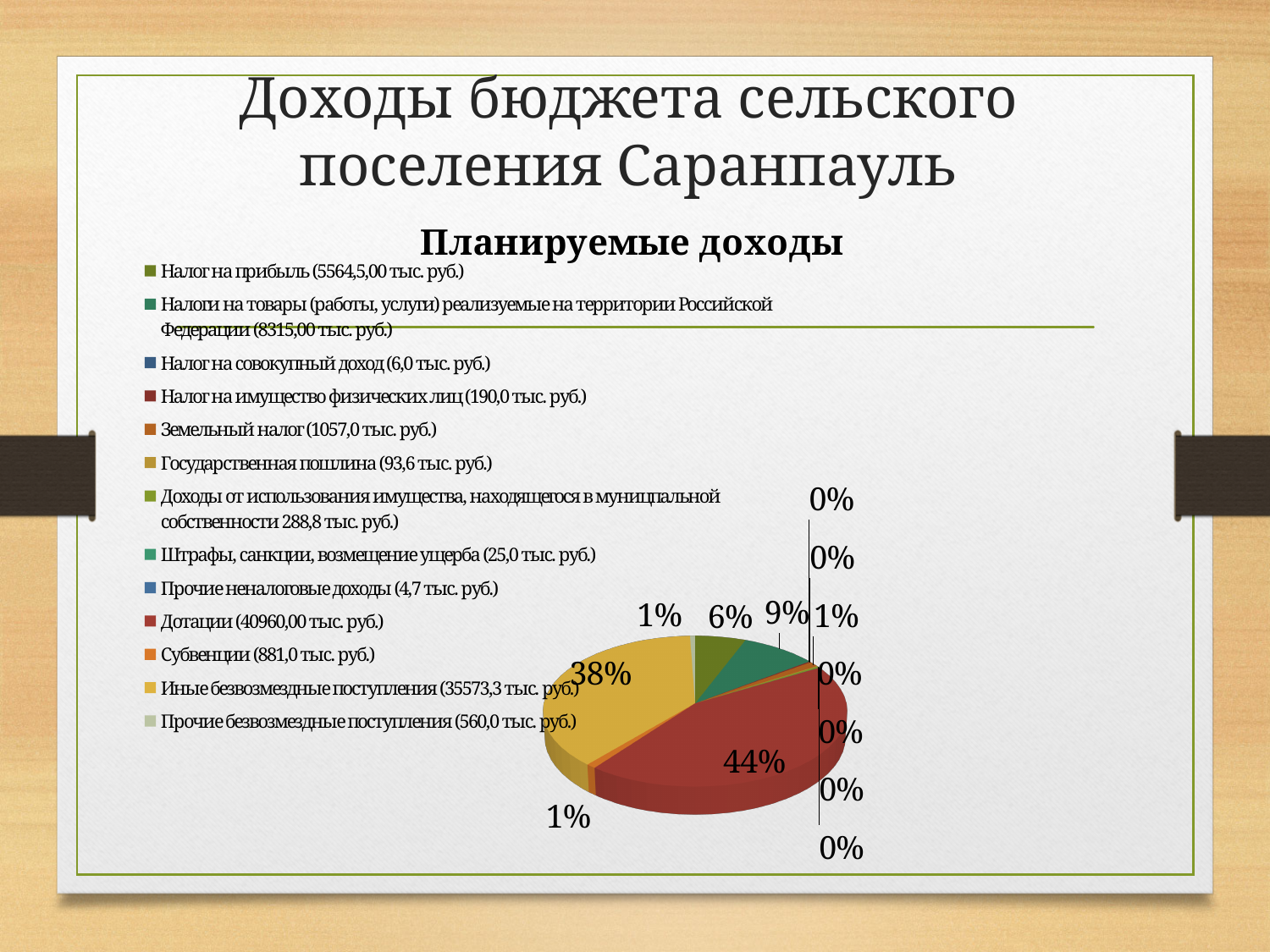
By how many percentage points does the Дотации share exceed the Иные безвозмездные поступления share? 6 percentage points What is the title of the chart? Планируемые доходы According to the legend, what is the planned amount for Дотации? 40960,00 тыс. руб. Which is larger: the slice for Дотации or the slice for Иные безвозмездные поступления? Дотации According to the legend, what is the planned amount for Земельный налог? 1057,0 тыс. руб. What share of the pie does Иные безвозмездные поступления represent? 38% Which category has the largest slice of the pie? Дотации What share of the pie does Налог на прибыль represent? 6% What share of the pie does Дотации represent? 44% How many entries does the chart legend list? 13 What kind of chart is shown on the slide? Pie chart